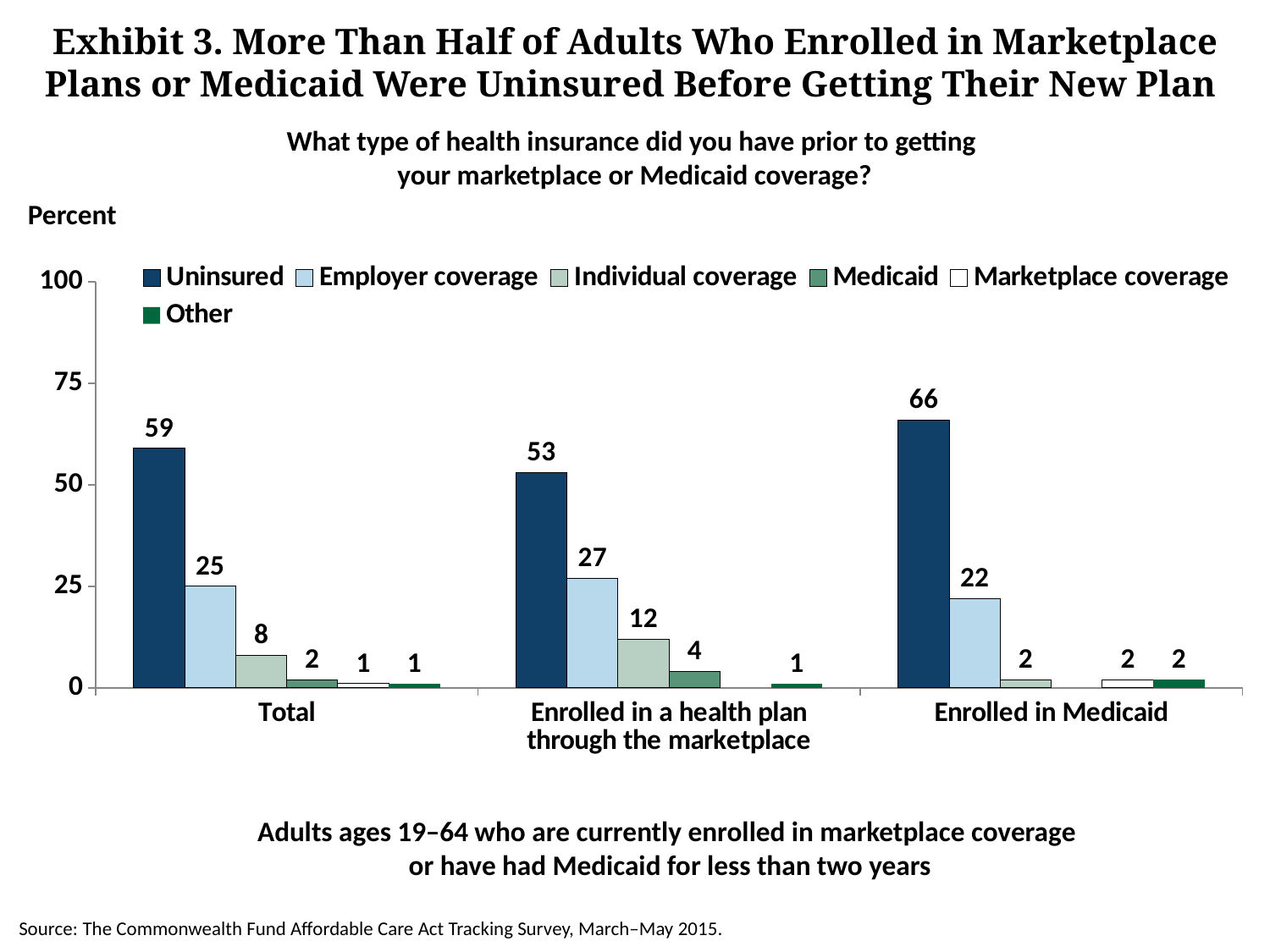
Which is larger: the Employer coverage value for Total or for Enrolled in Medicaid? Total What is the value for Individual coverage in the Total group? 8 What percentage of adults enrolled in Medicaid were uninsured before getting their new plan? 66 Which group has the lowest Uninsured value? Enrolled in a health plan through the marketplace What kind of chart is shown on the slide? Bar chart What is the value for Employer coverage in the 'Enrolled in a health plan through the marketplace' group? 27 How many series does the legend list? 6 What is the label on the y axis? Percent How many groups are shown on the x axis? 3 Which group has the highest Uninsured value? Enrolled in Medicaid What is the difference between the Uninsured values for 'Enrolled in Medicaid' and 'Enrolled in a health plan through the marketplace'? 13 Is the Uninsured value for the Total group greater or less than 50? greater